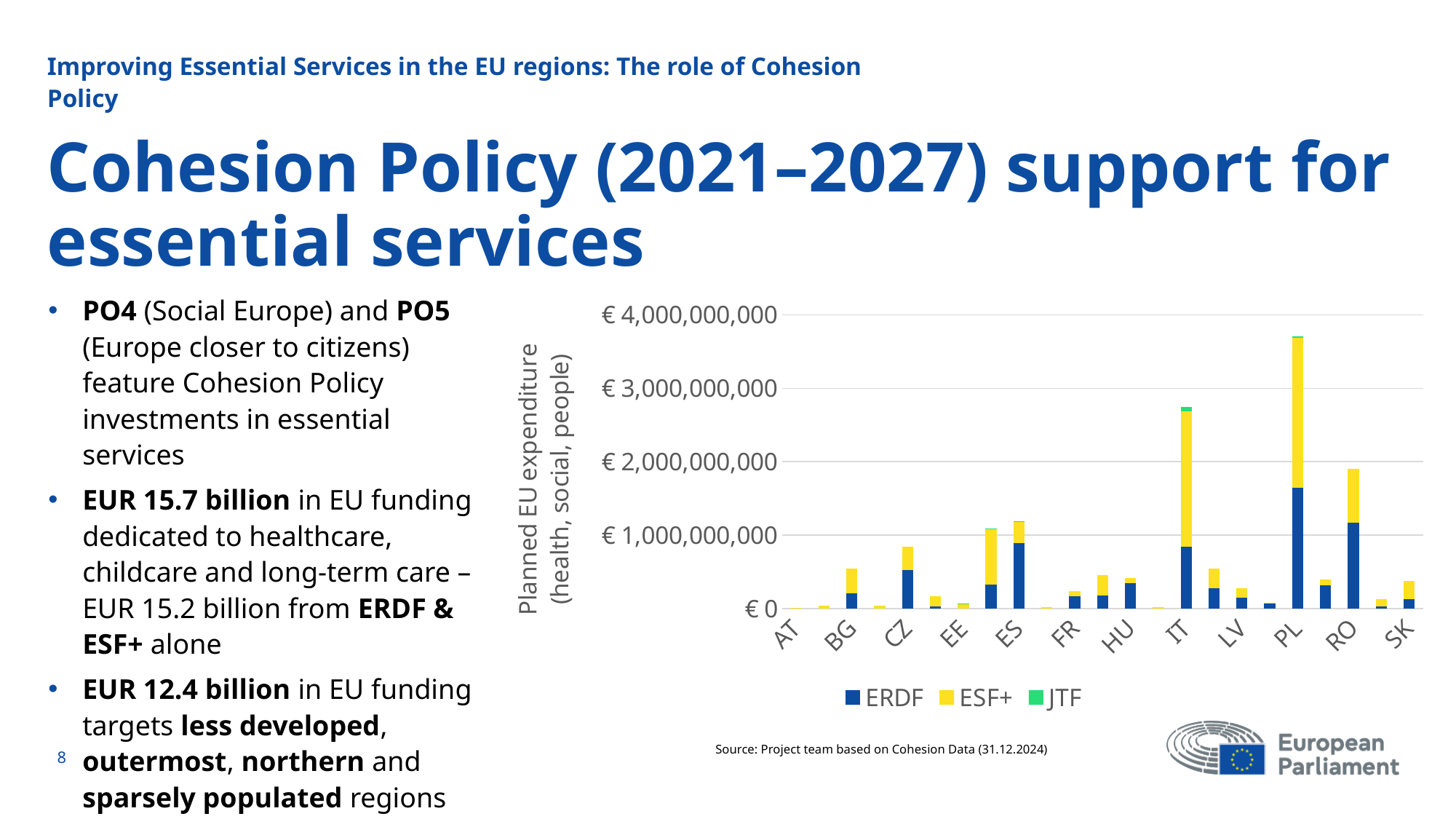
Which has a larger total planned EU expenditure, IT or RO? IT Is the total value for CZ greater or less than € 1,000,000,000? less Is the total value for RO greater or less than € 2,000,000,000? less What kind of chart is shown on the slide? Stacked bar chart Which has a larger total planned EU expenditure, ES or CZ? ES Is the total value for IT greater or less than € 2,000,000,000? greater Which has a larger total planned EU expenditure, PL or IT? PL Which series is shown in yellow in the chart? ESF+ How many series does the chart legend list? 3 Which series are listed in the chart legend? ERDF, ESF+, JTF Which country has the highest total planned EU expenditure in the chart? PL